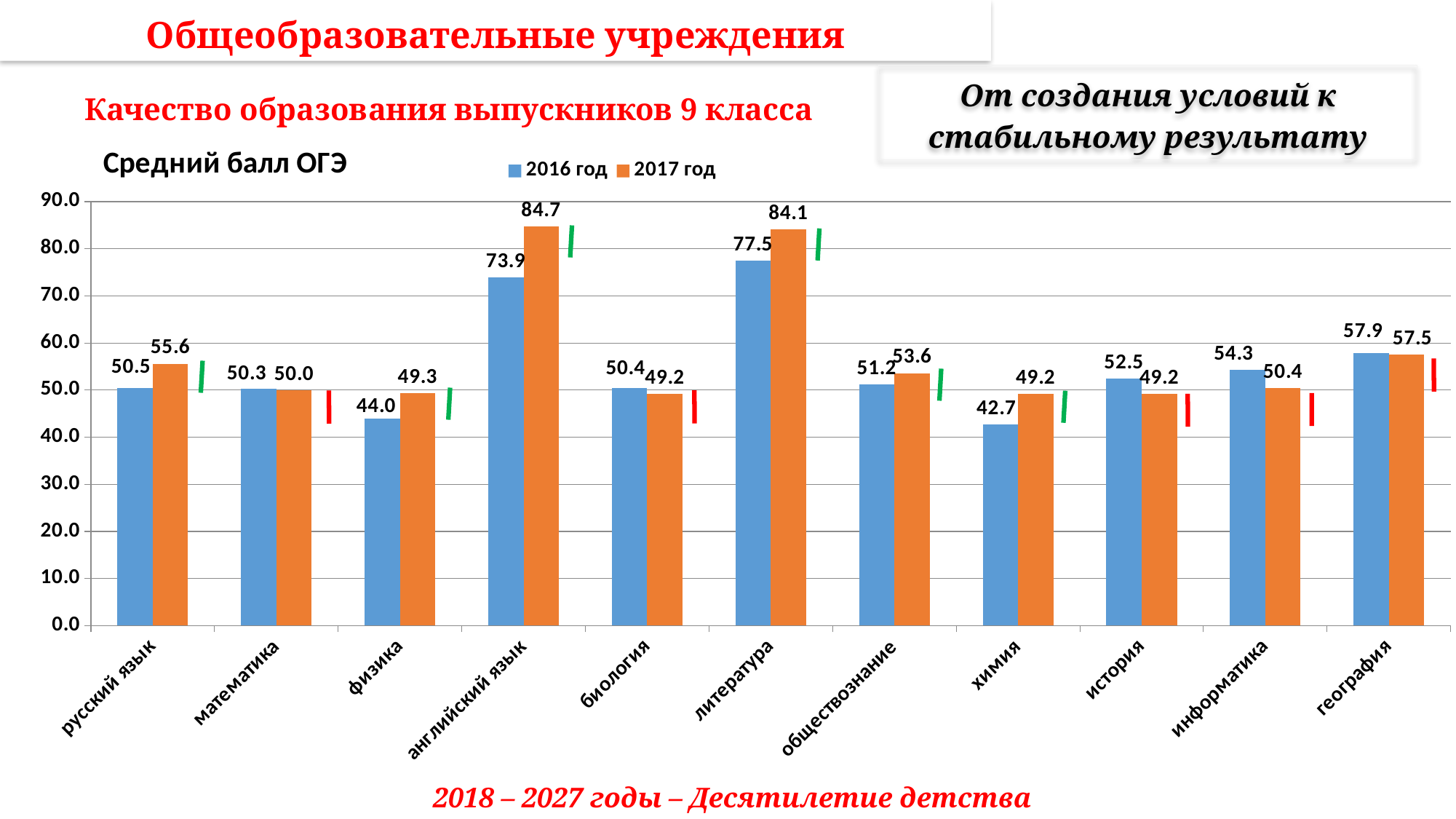
What is the 2017 год value for физика? 49.3 What is the 2016 год value for химия? 42.7 What is the difference between the 2017 год and 2016 год values for английский язык? 10.8 How many series does the legend list? 2 Is the 2016 год value for физика greater or less than 50.0? less Which subject has the highest 2017 год value? английский язык Which subject has the lowest 2016 год value? химия Which is larger for история: the 2016 год value or the 2017 год value? 2016 год How many subjects are shown on the x axis? 11 What is the 2017 год value for английский язык? 84.7 What kind of chart is shown on the slide? bar chart Which subject has the highest 2016 год value? литература